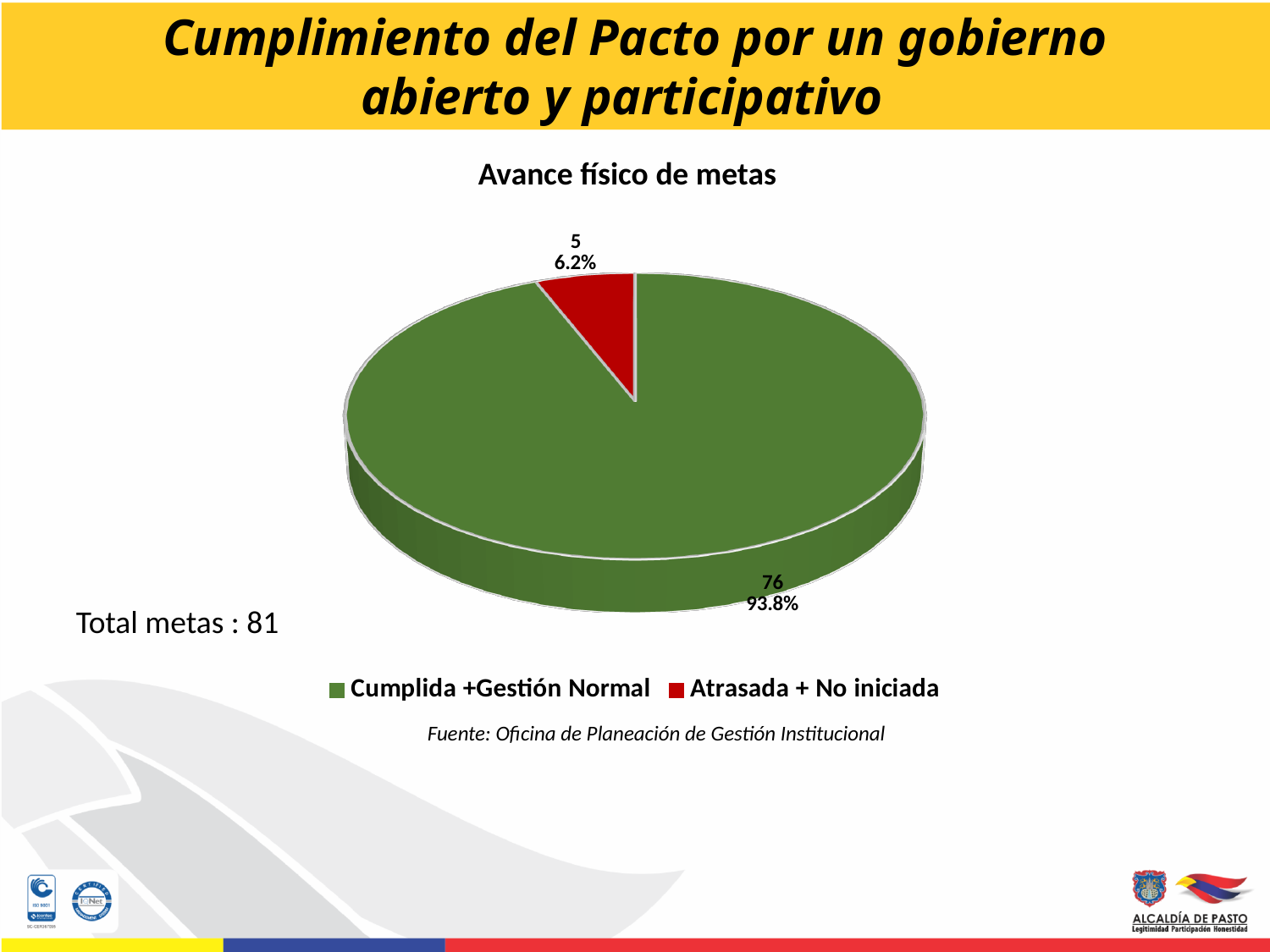
What is the value for Atrasada + No iniciada? 5 What is the value for Cumplida +Gestión Normal? 76 Which category has the largest slice? Cumplida +Gestión Normal Which colour represents Atrasada + No iniciada in the chart? red What share of the pie does Atrasada + No iniciada represent? 6.2% What share of the pie does Cumplida +Gestión Normal represent? 93.8% Which category has the smallest slice? Atrasada + No iniciada What is the title of the chart? Avance físico de metas How many slices does the pie chart have? 2 How many entries does the legend list? 2 What is the difference between the values for Cumplida +Gestión Normal and Atrasada + No iniciada? 71 What kind of chart is shown on the slide? pie chart